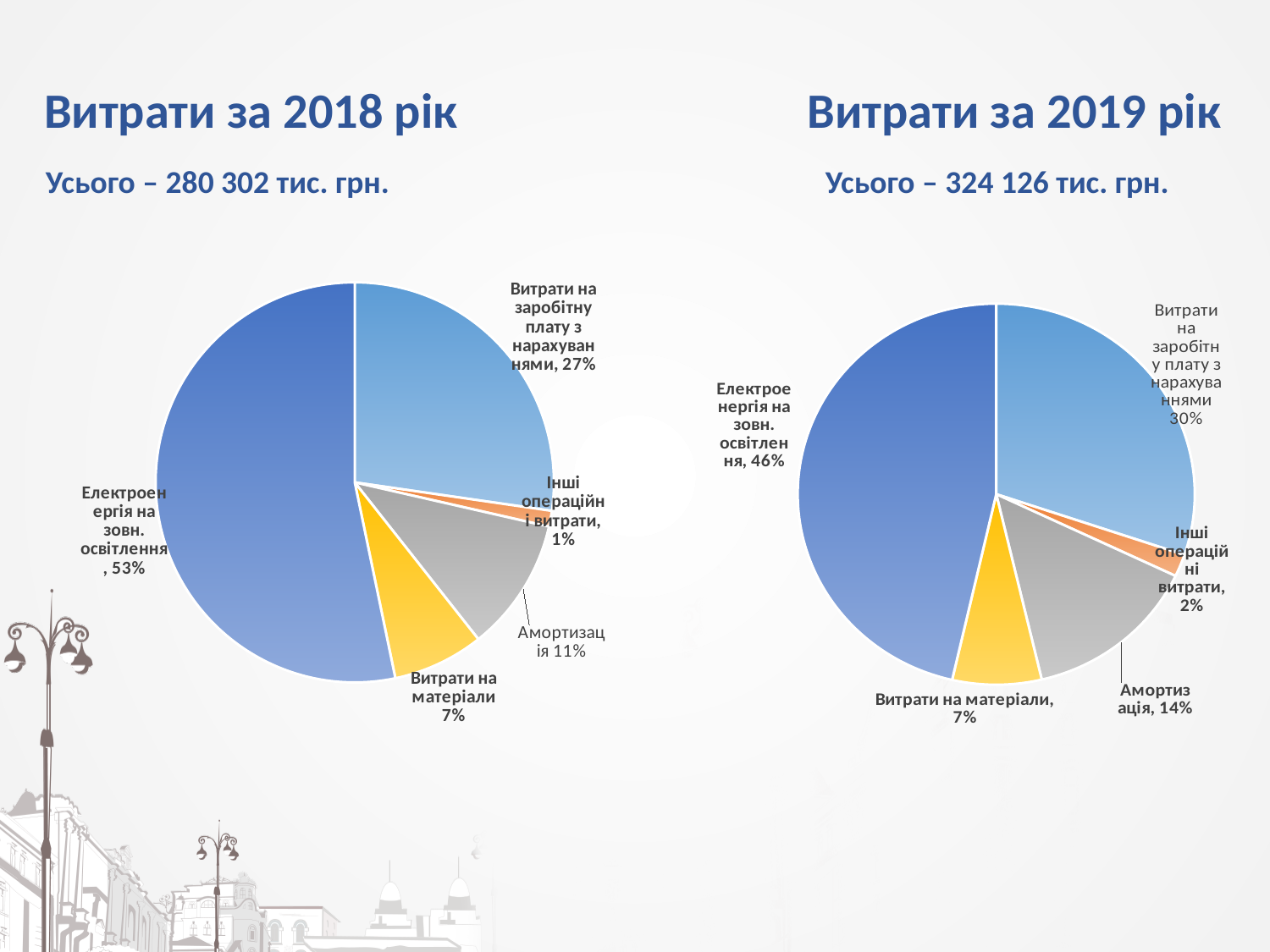
How many slices does the chart titled "Витрати за 2019 рік" have? 5 In the chart titled "Витрати за 2019 рік", what share of the pie is "Електроенергія на зовн. освітлення"? 46% In the chart titled "Витрати за 2019 рік", what is the value for "Витрати на заробітну плату з нарахуваннями"? 30% In the chart titled "Витрати за 2019 рік", what is the difference between "Амортизація" and "Витрати на матеріали"? 7% What total is stated under the title "Витрати за 2019 рік"? 324 126 тис. грн. In the chart titled "Витрати за 2018 рік", what is the value for "Амортизація"? 11% In the chart titled "Витрати за 2019 рік", which category has the largest slice? Електроенергія на зовн. освітлення What kind of chart is the chart titled "Витрати за 2018 рік"? Pie chart In the chart titled "Витрати за 2018 рік", what is the value for "Інші операційні витрати"? 1% In the chart titled "Витрати за 2018 рік", what share of the pie is "Електроенергія на зовн. освітлення"? 53% In the chart titled "Витрати за 2018 рік", which is larger: "Амортизація" or "Витрати на матеріали"? Амортизація In the chart titled "Витрати за 2018 рік", which category has the smallest slice? Інші операційні витрати